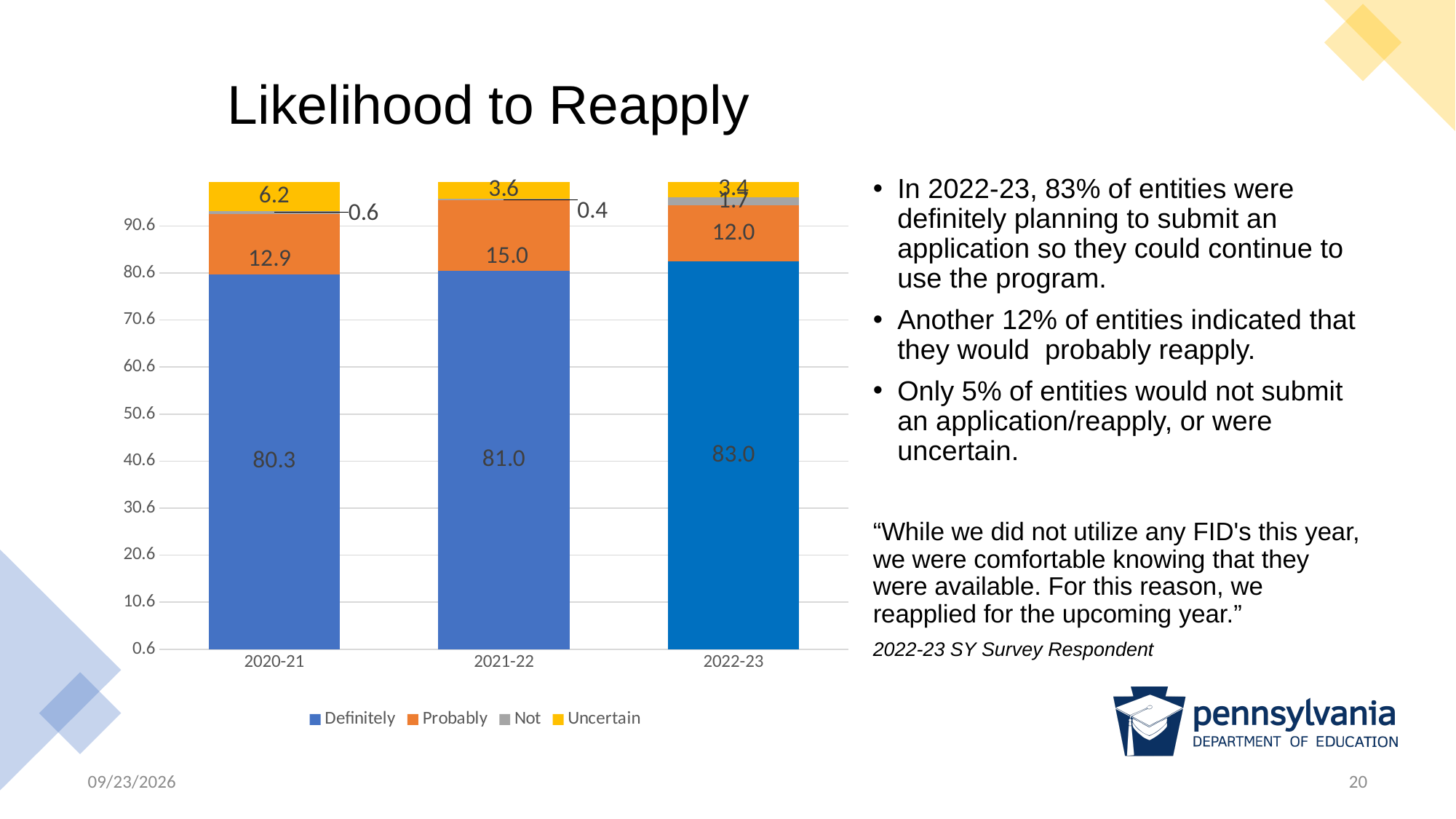
What is the Definitely value for 2022-23? 83.0 What is the Not value for 2022-23? 1.7 Which year has the highest Definitely value? 2022-23 How many series does the legend list? 4 How many school-year categories are shown on the x axis? 3 Is the Probably value larger in 2021-22 or in 2022-23? 2021-22 What is the Uncertain value for 2020-21? 6.2 What kind of chart is shown on the slide? Stacked bar chart What is the Probably value for 2021-22? 15.0 Does the Definitely value rise or fall from 2020-21 to 2022-23? Rise Which year has the lowest Uncertain value? 2022-23 What is the difference between the Definitely values for 2022-23 and 2020-21? 2.7